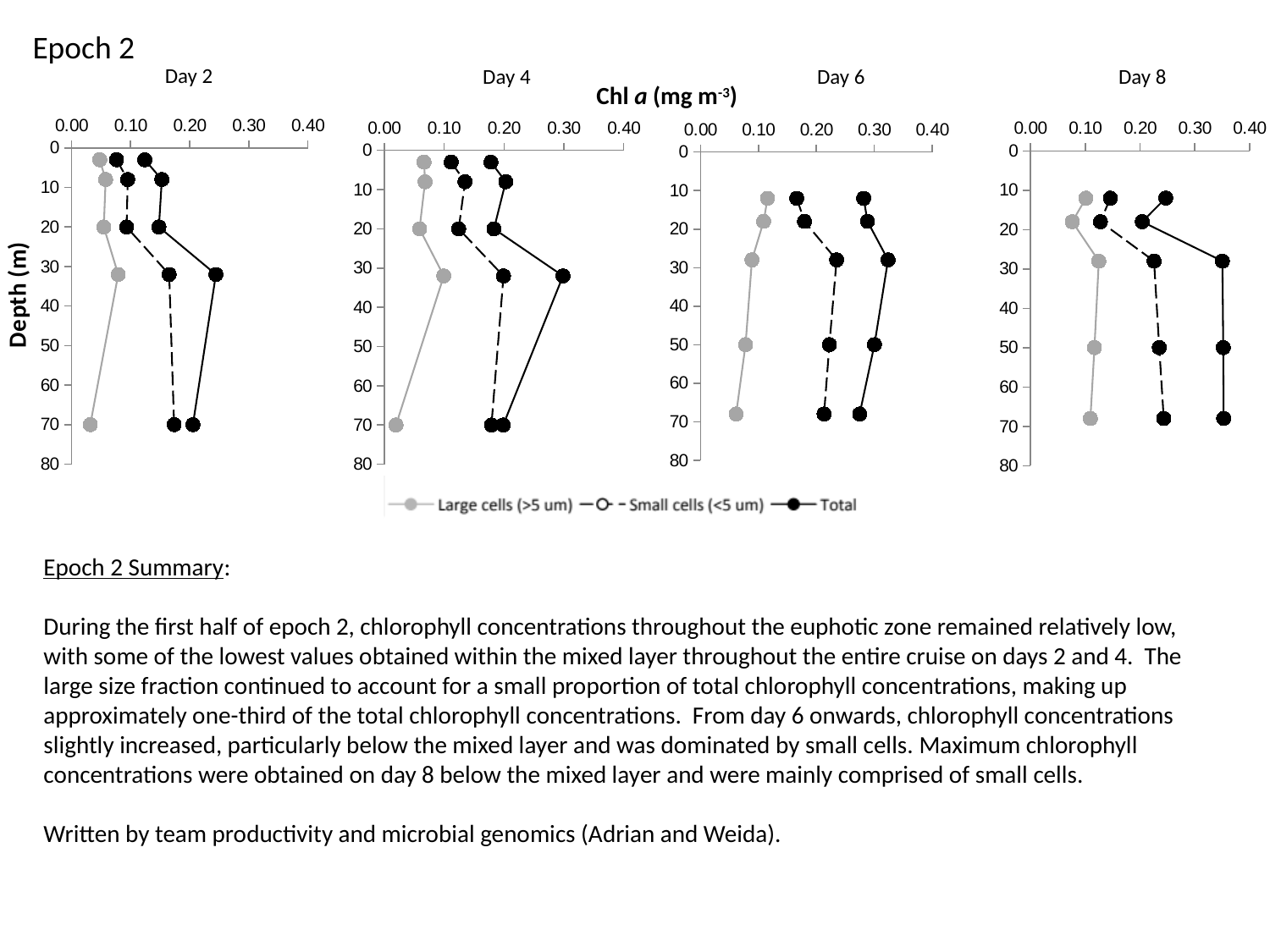
In the Day 2 chart, how many depth points are plotted for the Total series? 5 What are the three series named in the legend? Large cells (>5 um), Small cells (<5 um), Total What is the x-axis title shared by the four charts? Chl a (mg m-3) In the Day 2 chart, does the Large cells (>5 um) value increase or decrease from 32 m to 70 m depth? decrease In the Day 8 chart, which series has the highest value at 28 m depth? Total In the Day 8 chart, is the Total value at 68 m depth greater or less than 0.30? greater In the Day 2 chart, is the Large cells (>5 um) value at 70 m depth greater or less than 0.10? less In the Day 4 chart, is the Total value at 32 m depth greater or less than 0.20? greater In the Day 6 chart, at 50 m depth, which is larger: the Large cells (>5 um) value or the Small cells (<5 um) value? Small cells (<5 um) How many series does the legend list for these charts? 3 What kind of chart is the Day 2 chart? line chart